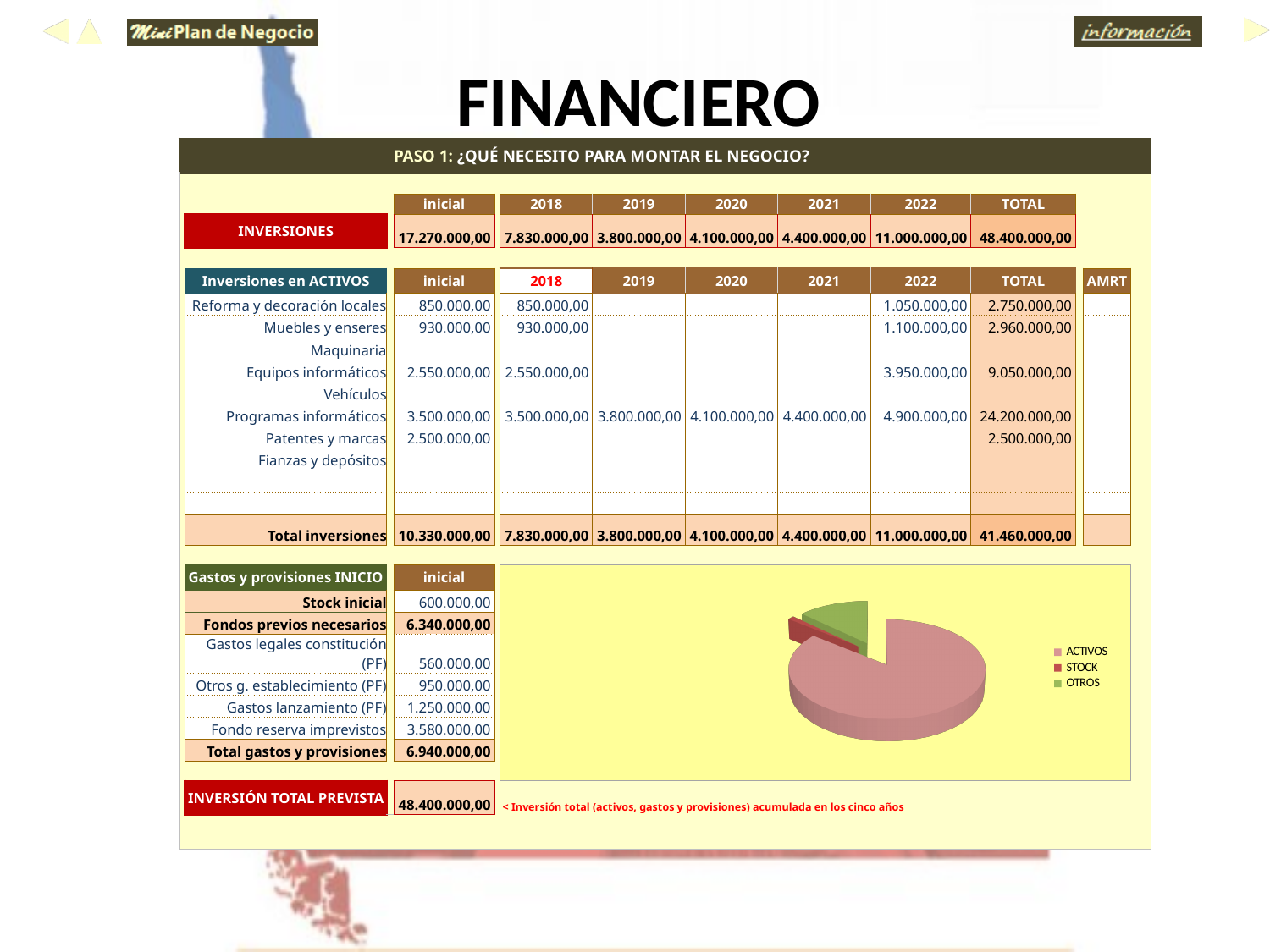
What are the legend entries of the pie chart? ACTIVOS, STOCK, OTROS What colour is the OTROS slice in the pie chart? Green In the pie chart, which slice is larger, ACTIVOS or OTROS? ACTIVOS In the pie chart, which slice is larger, OTROS or STOCK? OTROS Which category has the smallest slice in the pie chart? STOCK What kind of chart is shown on the slide? Pie chart How many entries does the pie chart's legend list? 3 How many slices does the pie chart have? 3 Which category has the largest slice in the pie chart? ACTIVOS